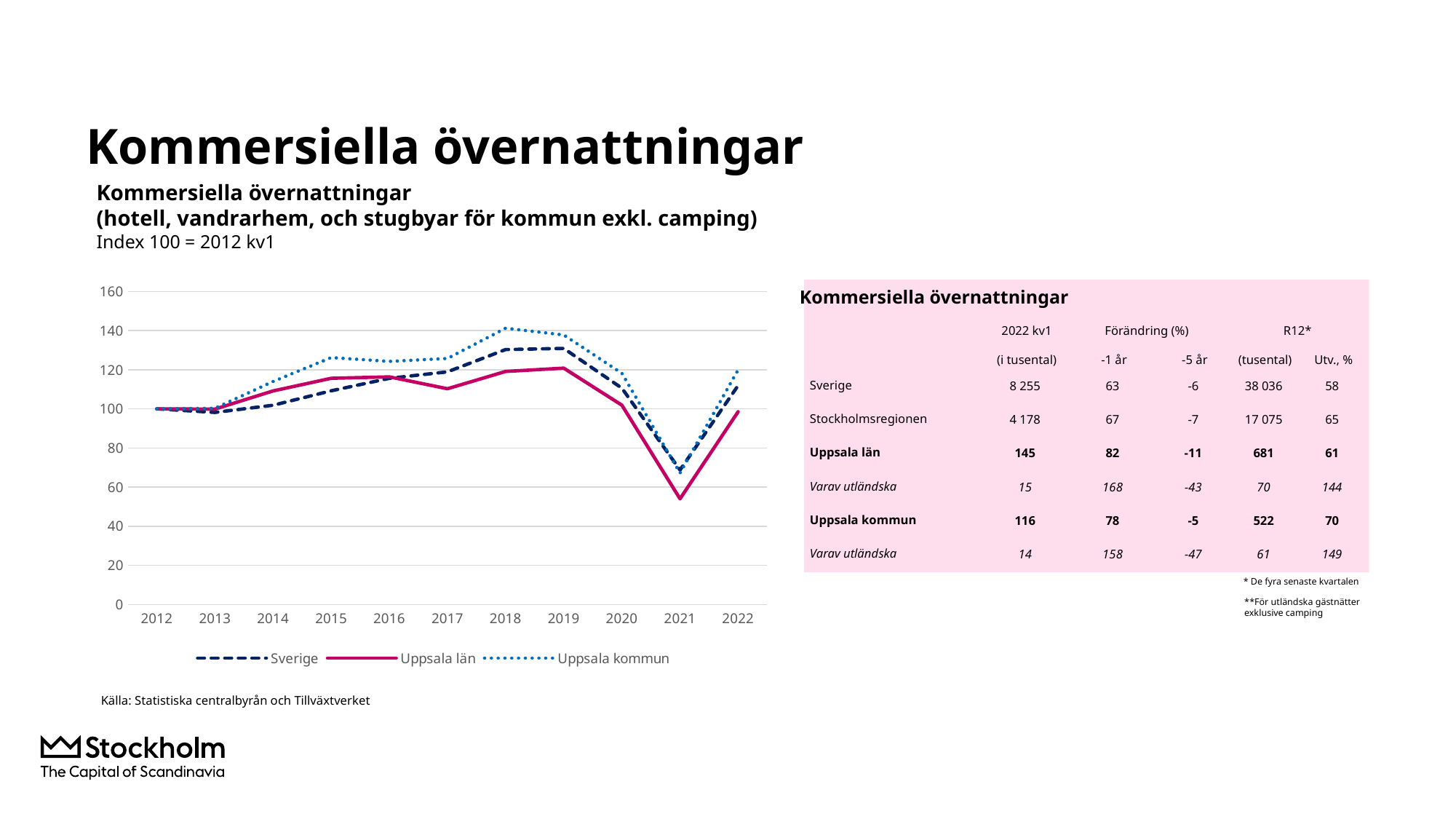
Is the value for Sverige in 2019 greater or less than 120? greater Is the value for Uppsala län in 2021 greater or less than 60? less Which series are listed in the chart legend? Sverige, Uppsala län, Uppsala kommun Do the values for Uppsala kommun rise or fall between 2019 and 2021? fall Is the value for Uppsala kommun in 2015 greater or less than 120? greater How many years are shown along the x axis of the chart? 11 In which year does the Uppsala län series reach its lowest value? 2021 In 2018, which series has the higher value, Uppsala kommun or Uppsala län? Uppsala kommun What is the index base stated for the chart? Index 100 = 2012 kv1 What kind of chart is shown on the slide? line chart How many series does the chart legend list? 3 In 2021, which series has the higher value, Sverige or Uppsala län? Sverige